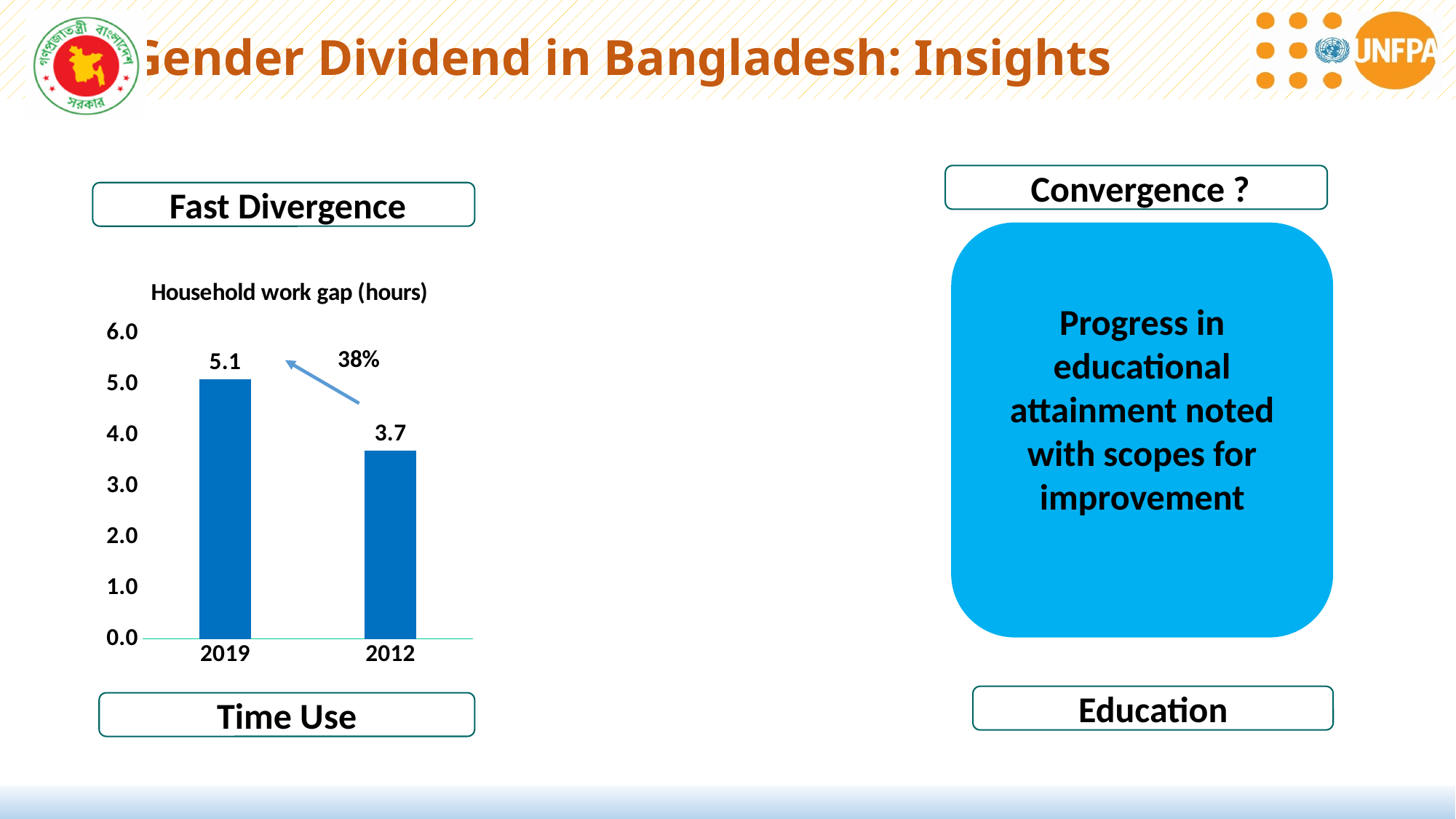
Is the household work gap larger in 2019 or in 2012? 2019 What is the difference between the household work gap in 2019 and in 2012? 1.4 Which year has the lower household work gap? 2012 Is the value for 2012 greater or less than 4.0? less What kind of chart is used to show the household work gap? bar chart What percentage is annotated next to the arrow on the chart? 38% What is the household work gap in hours for 2019? 5.1 How many years are shown on the chart? 2 What is the household work gap in hours for 2012? 3.7 Which year has the higher household work gap? 2019 What is the title of the chart? Household work gap (hours) Is the value for 2019 greater or less than 5.0? greater